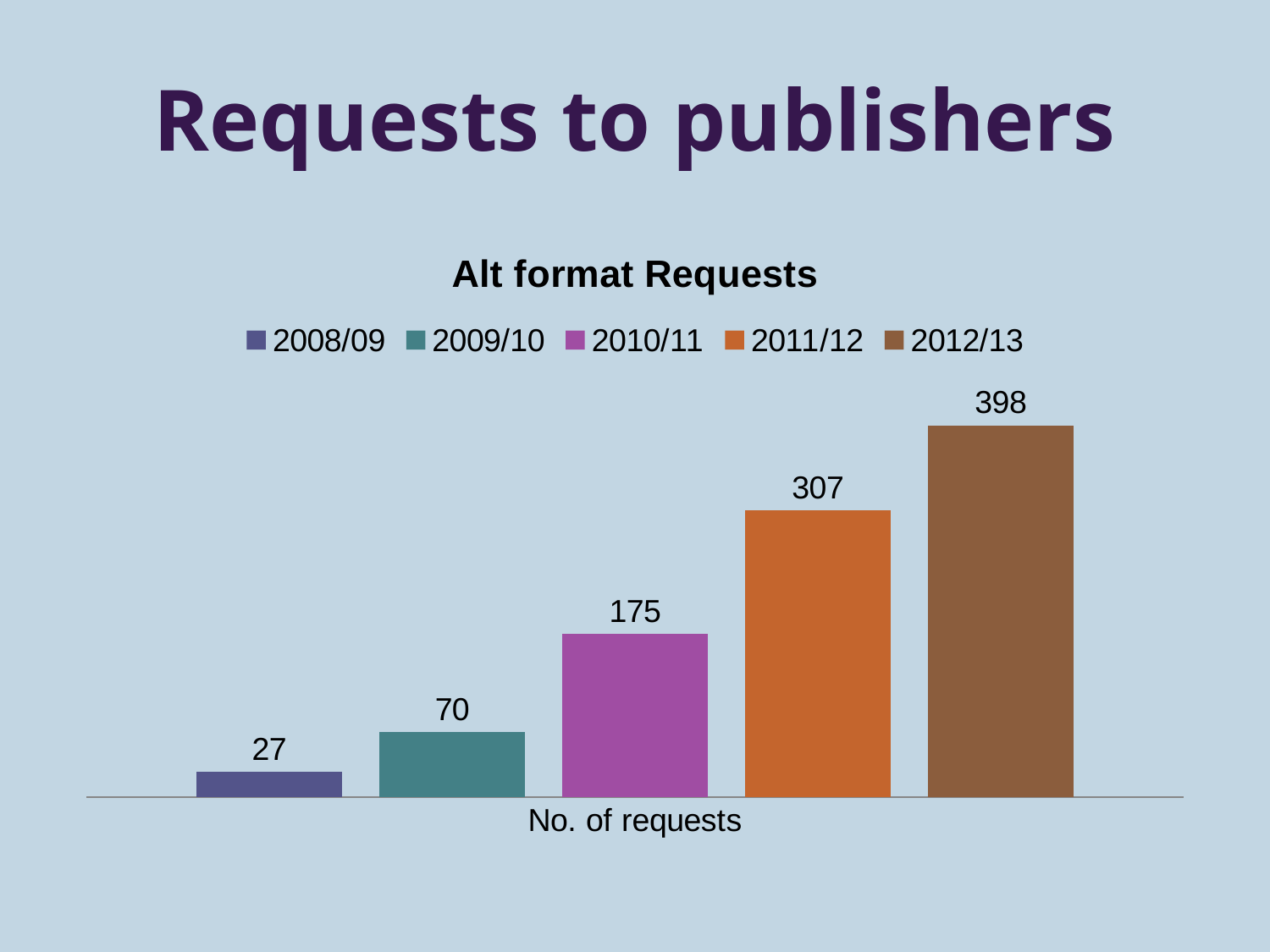
Which has more requests, 2009/10 or 2011/12? 2011/12 Which year has the lowest number of requests? 2008/09 What is the number of requests for 2008/09? 27 What is the number of requests for 2010/11? 175 How many series does the legend list? 5 What is the number of requests for 2012/13? 398 What is the difference in requests between 2012/13 and 2011/12? 91 Which year has the highest number of requests? 2012/13 What kind of chart is shown on the slide? Bar chart What is the title of the chart? Alt format Requests Do the number of requests rise or fall from 2008/09 to 2012/13? Rise What is the difference in requests between 2010/11 and 2009/10? 105